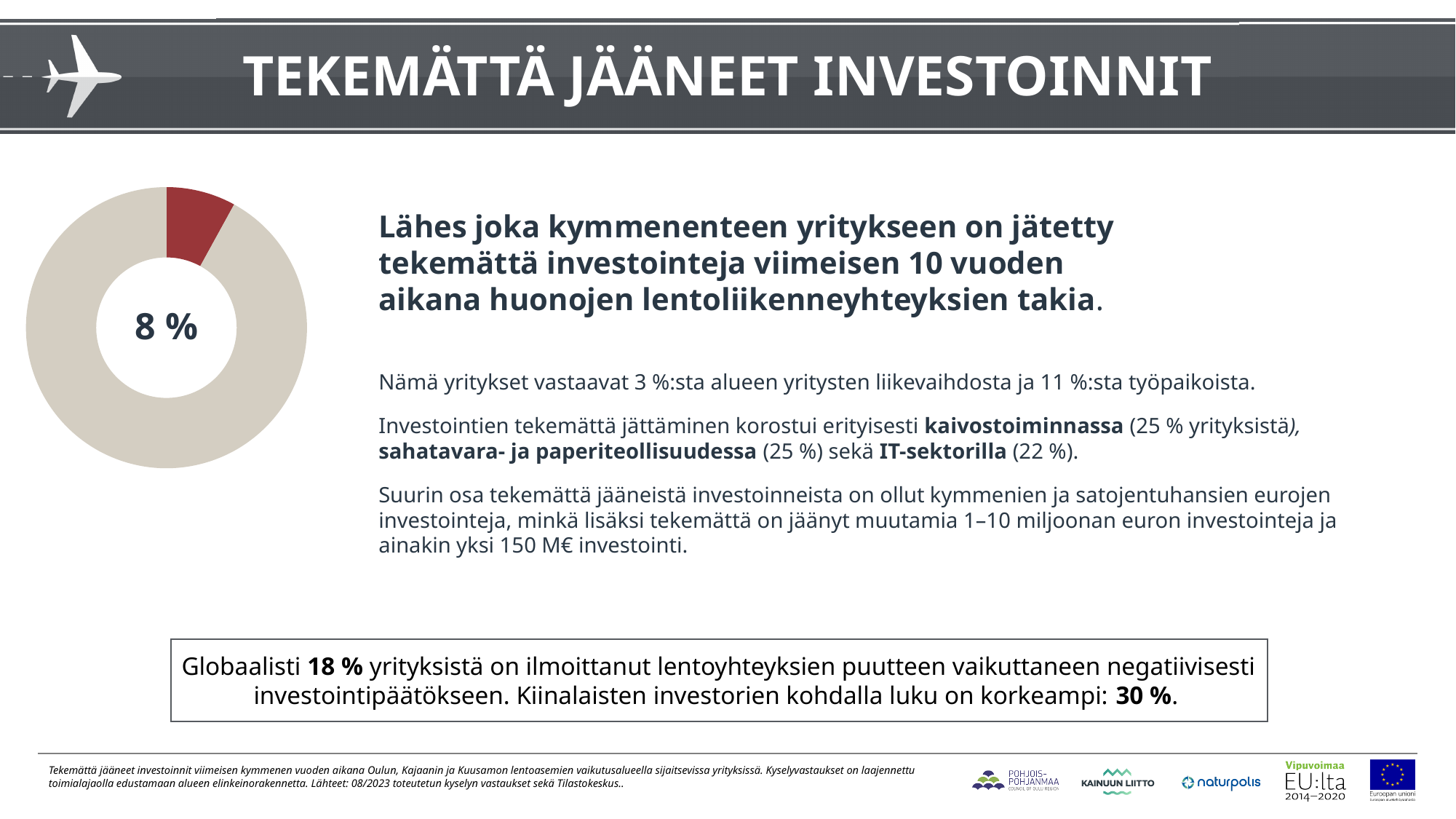
What colour is the slice that represents the 8 % share in the donut chart? Red Is the red slice of the donut chart greater or less than 50 % of the whole? less Which slice of the donut chart is larger, the red one or the beige one? The beige one What kind of chart is shown on the left of the slide? Donut (pie) chart How many slices does the donut chart have? 2 What share of the donut chart does the red (highlighted) slice represent? 8 % Does the donut chart have a legend? No What value is printed in the centre of the donut chart? 8 %